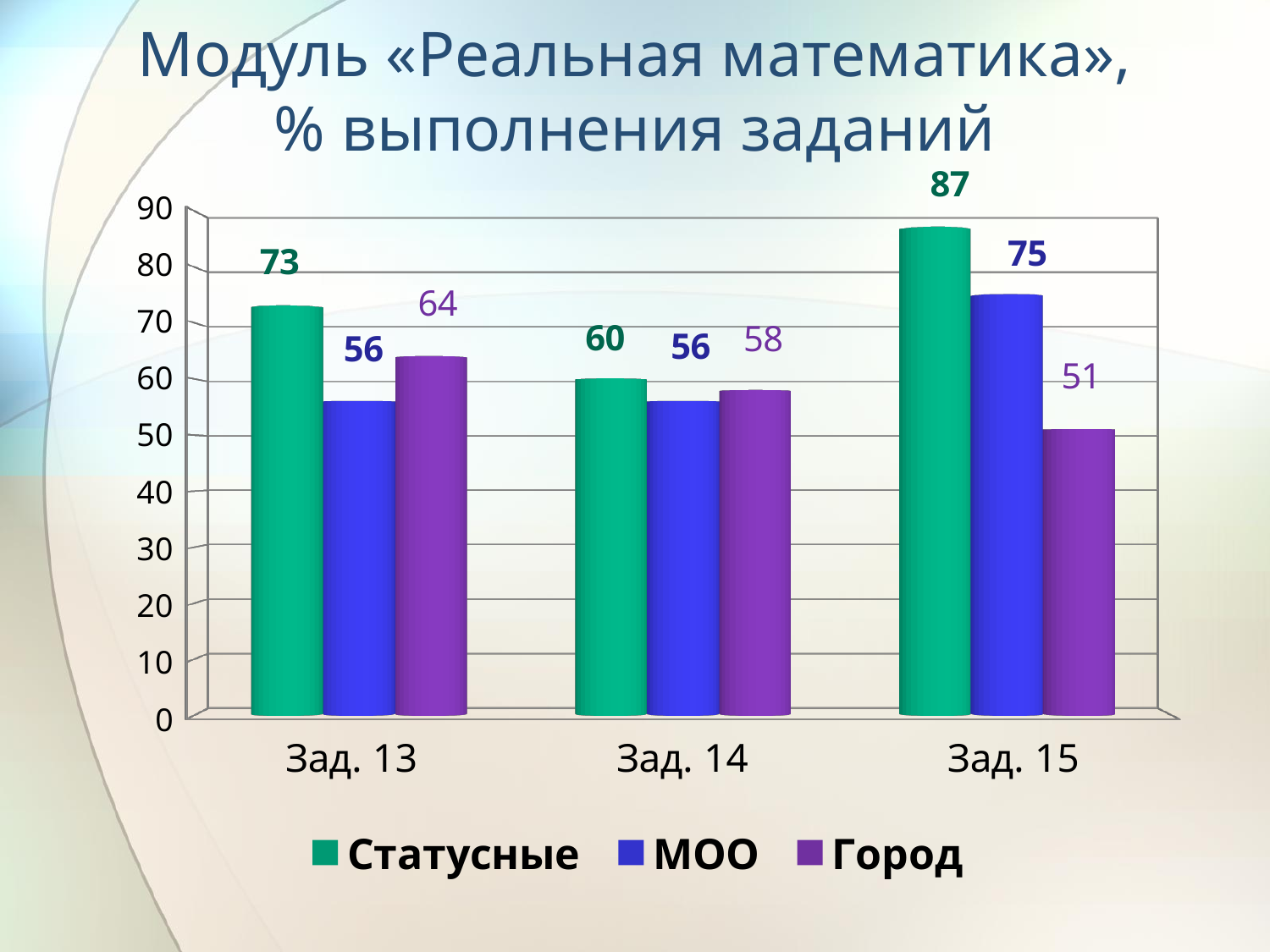
Which category has the lowest value for Город? Зад. 15 How many categories are shown on the x axis? 3 What is the value for Статусные in Зад. 13? 73 What kind of chart is shown on the slide? Bar chart What is the value for МОО in Зад. 14? 56 Which category has the highest value for Статусные? Зад. 15 Do the values for Город rise or fall from Зад. 13 to Зад. 15? Fall Which is larger in Зад. 13: Статусные or Город? Статусные How many series does the legend list? 3 What is the difference between Статусные and Город in Зад. 15? 36 What is the difference between Город and МОО in Зад. 13? 8 What is the value for Город in Зад. 15? 51